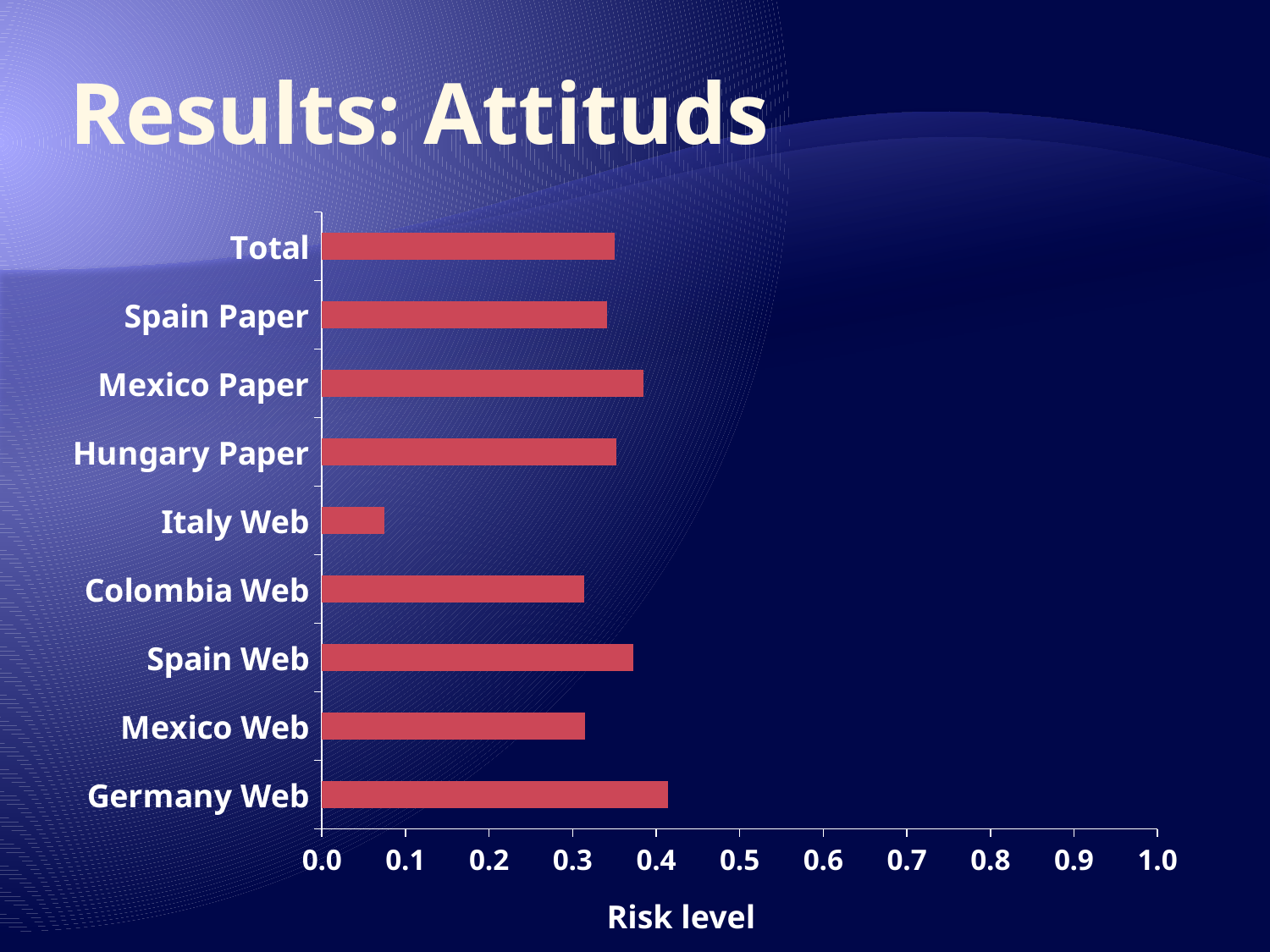
Which category has the lowest risk level? Italy Web How many categories are plotted in the chart? 9 What kind of chart is shown on the slide? bar chart Which is larger, the value for Mexico Paper or the value for Colombia Web? Mexico Paper What is the label of the horizontal axis? Risk level Which category has the highest risk level? Germany Web Is the value for Germany Web greater or less than 0.4? greater What is the title of the slide? Results: Attituds Is the value for Mexico Paper greater or less than 0.4? less Is the value for Hungary Paper greater or less than 0.3? greater Which is larger, the value for Spain Web or the value for Mexico Web? Spain Web